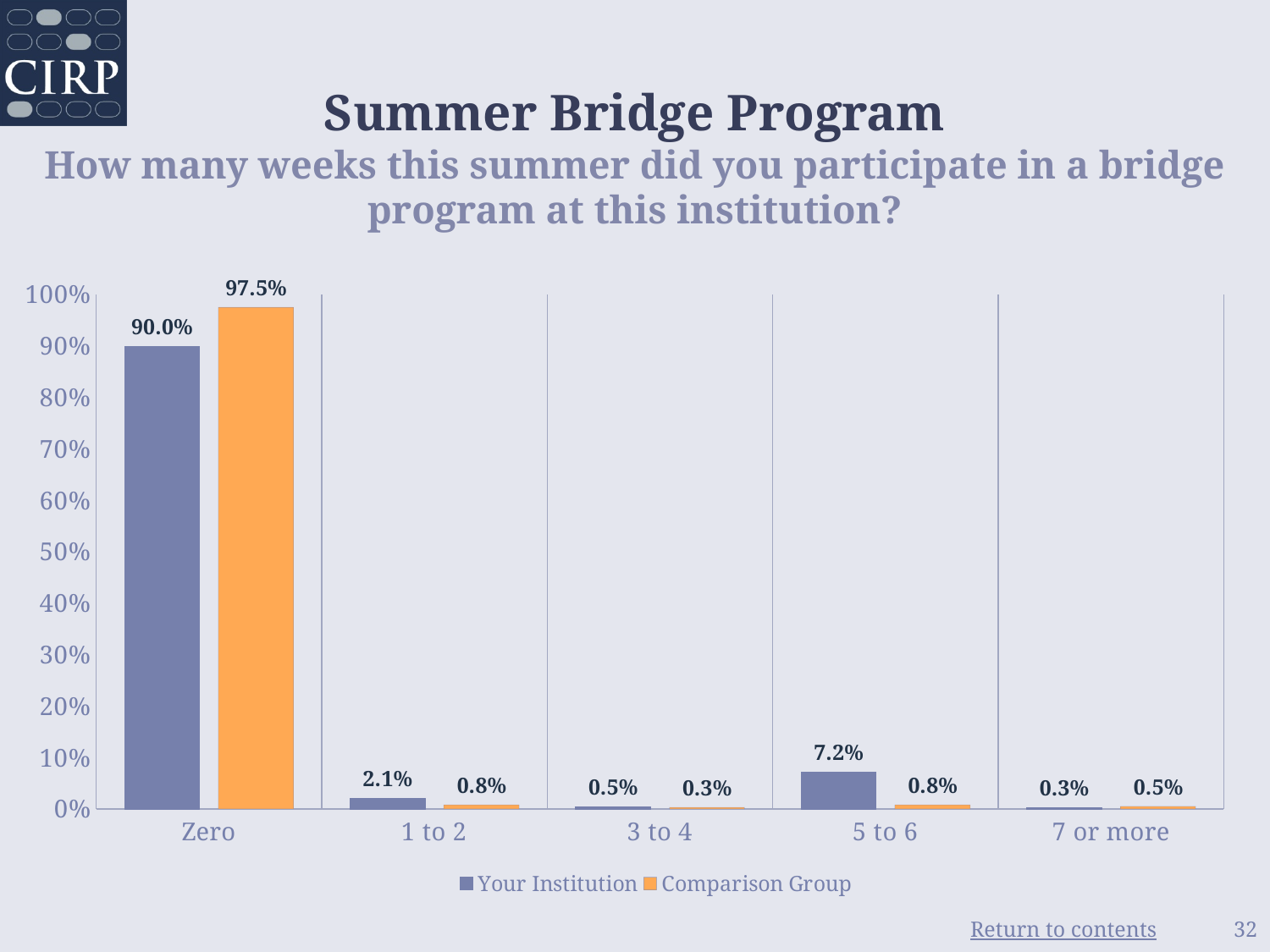
Which category has the lowest value for Comparison Group? 3 to 4 What is the difference between the Comparison Group and Your Institution values in the Zero category? 7.5% How many categories are shown on the x axis? 5 Which category has the highest value for Your Institution? Zero What kind of chart is shown on the slide? Bar chart What is the value for Your Institution in the Zero category? 90.0% What is the value for Comparison Group in the 1 to 2 category? 0.8% What is the value for Comparison Group in the Zero category? 97.5% What is the value for Your Institution in the 5 to 6 category? 7.2% In the 5 to 6 category, which series has the larger value, Your Institution or Comparison Group? Your Institution Is the value for Your Institution in the Zero category greater or less than 80%? greater How many series does the legend list? 2